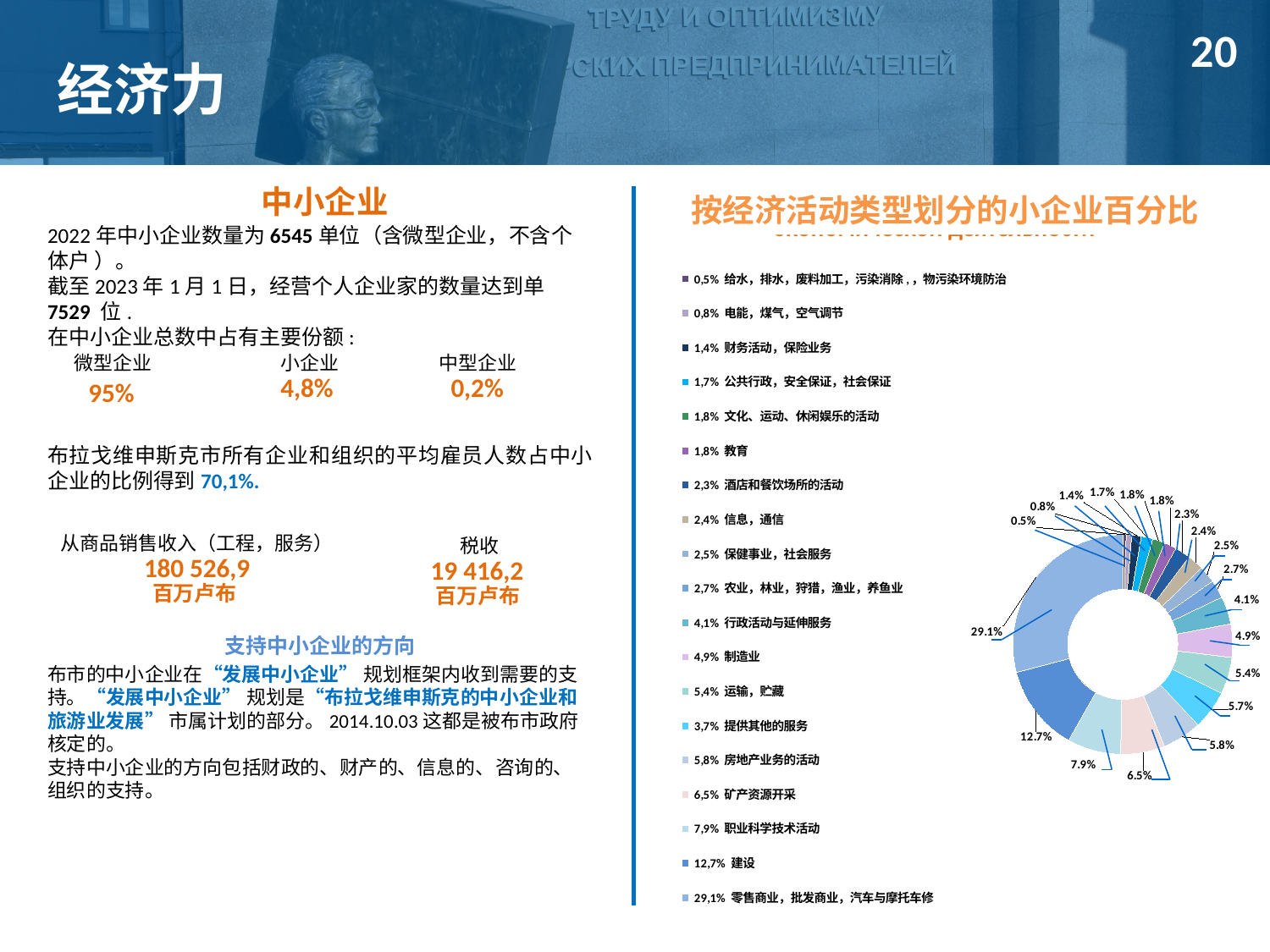
In the pie chart 按经济活动类型划分的小企业百分比, what is the share for 建设? 12,7% In the pie chart 按经济活动类型划分的小企业百分比, which has the larger share: 运输，贮藏 or 行政活动与延伸服务? 运输，贮藏 In the pie chart 按经济活动类型划分的小企业百分比, how many percentage points larger is the share of 建设 than that of 职业科学技术活动? 4,8 percentage points In the pie chart 按经济活动类型划分的小企业百分比, what is the combined share of 建设 and 零售商业，批发商业，汽车与摩托车修? 41,8% In the pie chart 按经济活动类型划分的小企业百分比, what is the share for 矿产资源开采? 6,5% In the pie chart 按经济活动类型划分的小企业百分比, which category has the largest share? 零售商业，批发商业，汽车与摩托车修 In the pie chart 按经济活动类型划分的小企业百分比, which category has the smallest share? 给水，排水，废料加工，污染消除，，物污染环境防治 What is the title of the pie chart on the right side of the slide? 按经济活动类型划分的小企业百分比 How many categories are listed in the legend of the pie chart 按经济活动类型划分的小企业百分比? 19 What kind of chart is shown on the right side of the slide under the title 按经济活动类型划分的小企业百分比? doughnut chart In the pie chart 按经济活动类型划分的小企业百分比, what is the share for 教育? 1,8% In the pie chart 按经济活动类型划分的小企业百分比, what is the share for 制造业? 4,9%